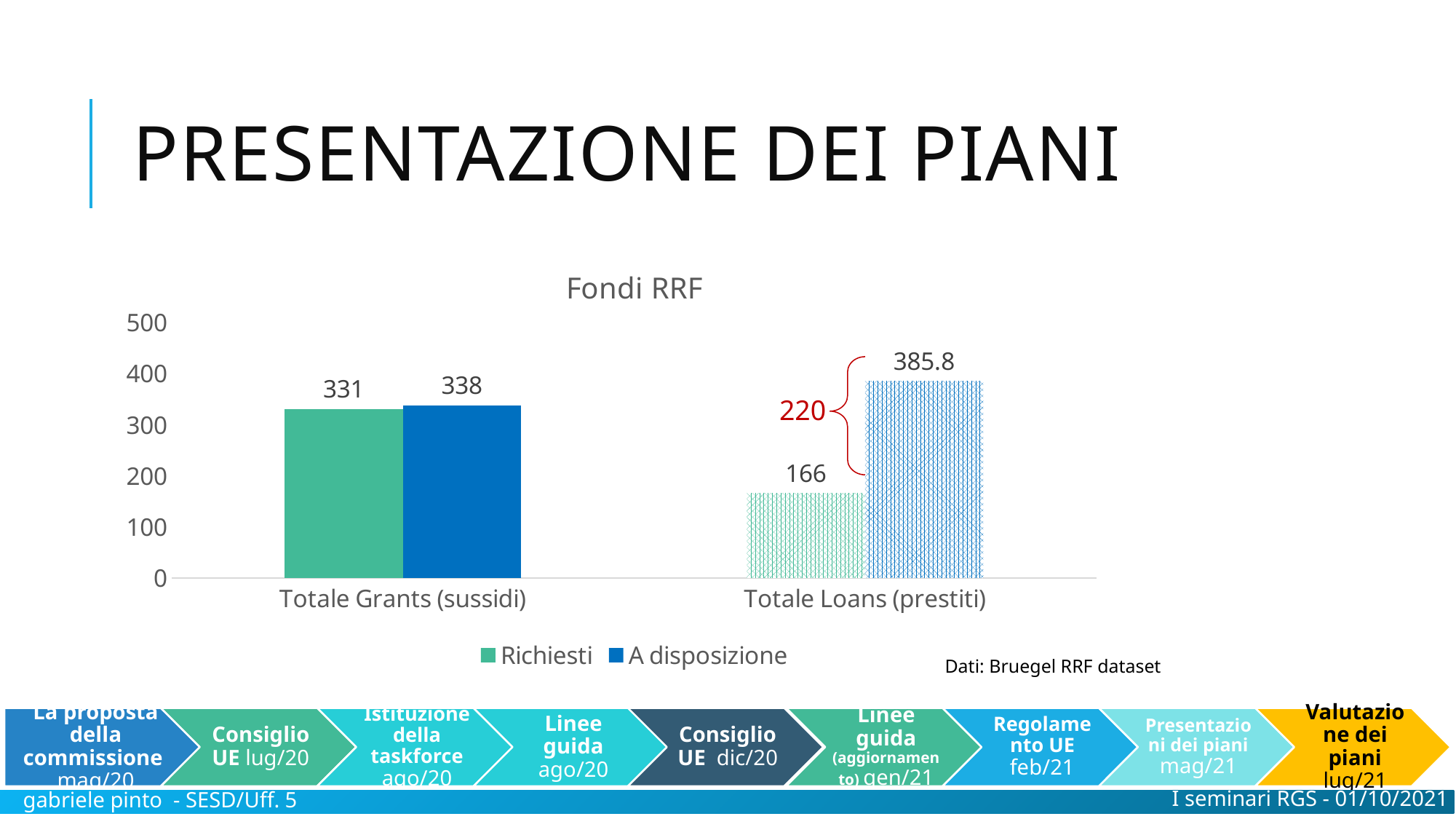
What is the value of Richiesti for Totale Loans (prestiti)? 166 How many categories are shown on the x axis? 2 Which bar has the lowest value in the chart? Richiesti for Totale Loans (prestiti) What is the title of the chart? Fondi RRF Which is larger for Totale Loans (prestiti): Richiesti or A disposizione? A disposizione What is the value of A disposizione for Totale Loans (prestiti)? 385.8 Which bar has the highest value in the chart? A disposizione for Totale Loans (prestiti) How many series does the legend list? 2 What type of chart is shown on the slide? bar chart What is the value of Richiesti for Totale Grants (sussidi)? 331 What is the value of A disposizione for Totale Grants (sussidi)? 338 What is the difference between A disposizione and Richiesti for Totale Grants (sussidi)? 7